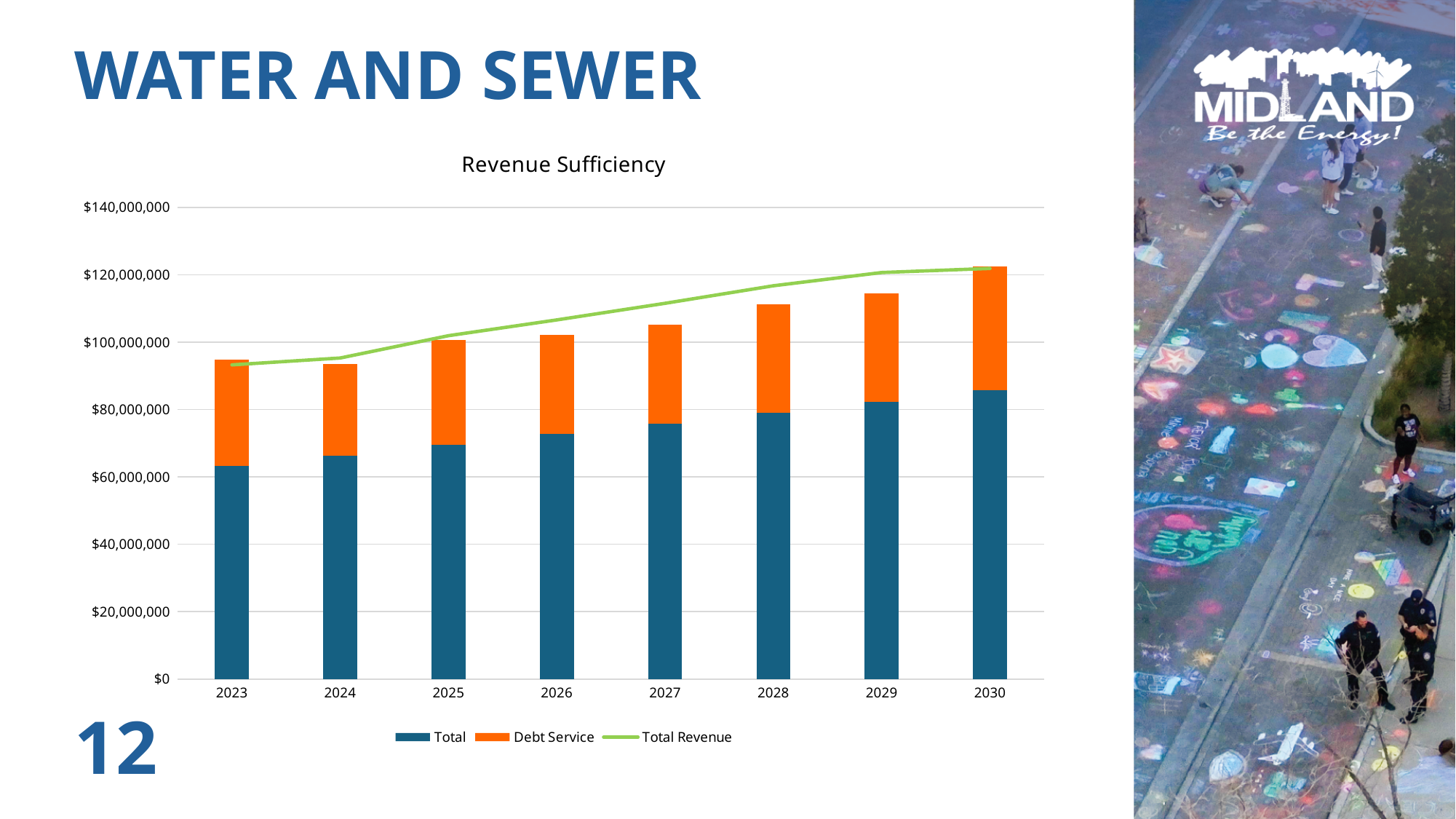
Which is larger, the Debt Service value for 2030 or for 2024? 2030 Which year has the highest Total value? 2030 How many series does the legend list? 3 How many years are shown on the x axis? 8 Is the Total value for 2023 greater or less than $60,000,000? greater Is the Total Revenue value for 2027 greater or less than $100,000,000? greater Is the Total value for 2030 greater or less than $80,000,000? greater Which year has the lowest Total value? 2023 Do the Total values rise or fall from 2023 to 2030? Rise What is the title of the chart? Revenue Sufficiency What kind of chart is this? Stacked bar chart with a line